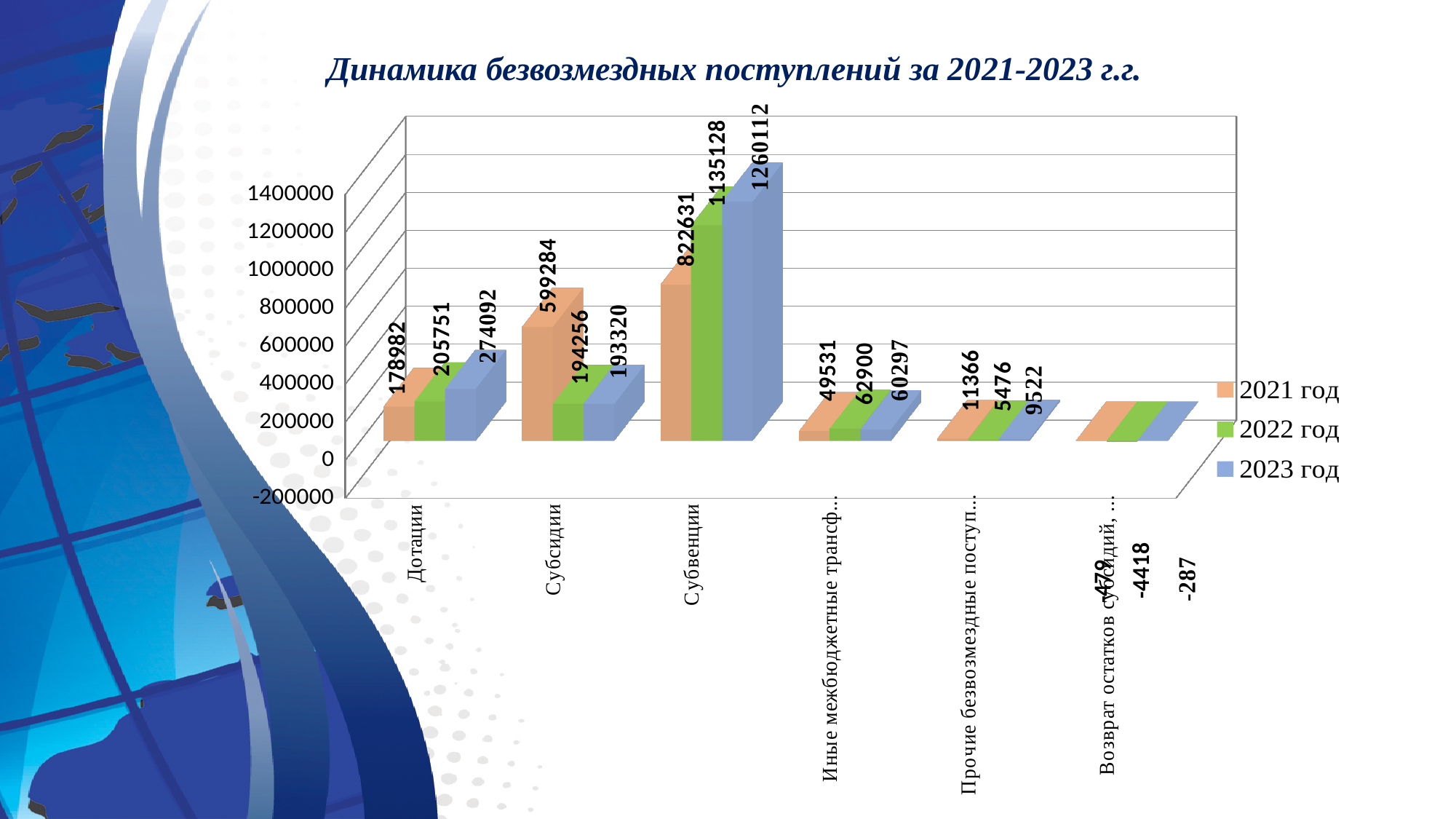
What is the value for Субвенции in 2022 год? 1135128 What is the value for Дотации in 2023 год? 274092 What kind of chart is shown on the slide? bar chart Do the values for Субвенции rise or fall from 2021 год to 2023 год? rise Is the value for Субвенции in 2023 год greater or less than 1200000? greater What is the difference between the 2023 год and 2021 год values for Субвенции? 437481 Which category has the highest value in 2023 год? Субвенции Which year has the lowest value for Дотации? 2021 год How many series does the legend list? 3 What is the value for Субсидии in 2021 год? 599284 Which is larger for Субсидии: the 2022 год value or the 2023 год value? 2022 год What is the title of the chart? Динамика безвозмездных поступлений за 2021-2023 г.г.